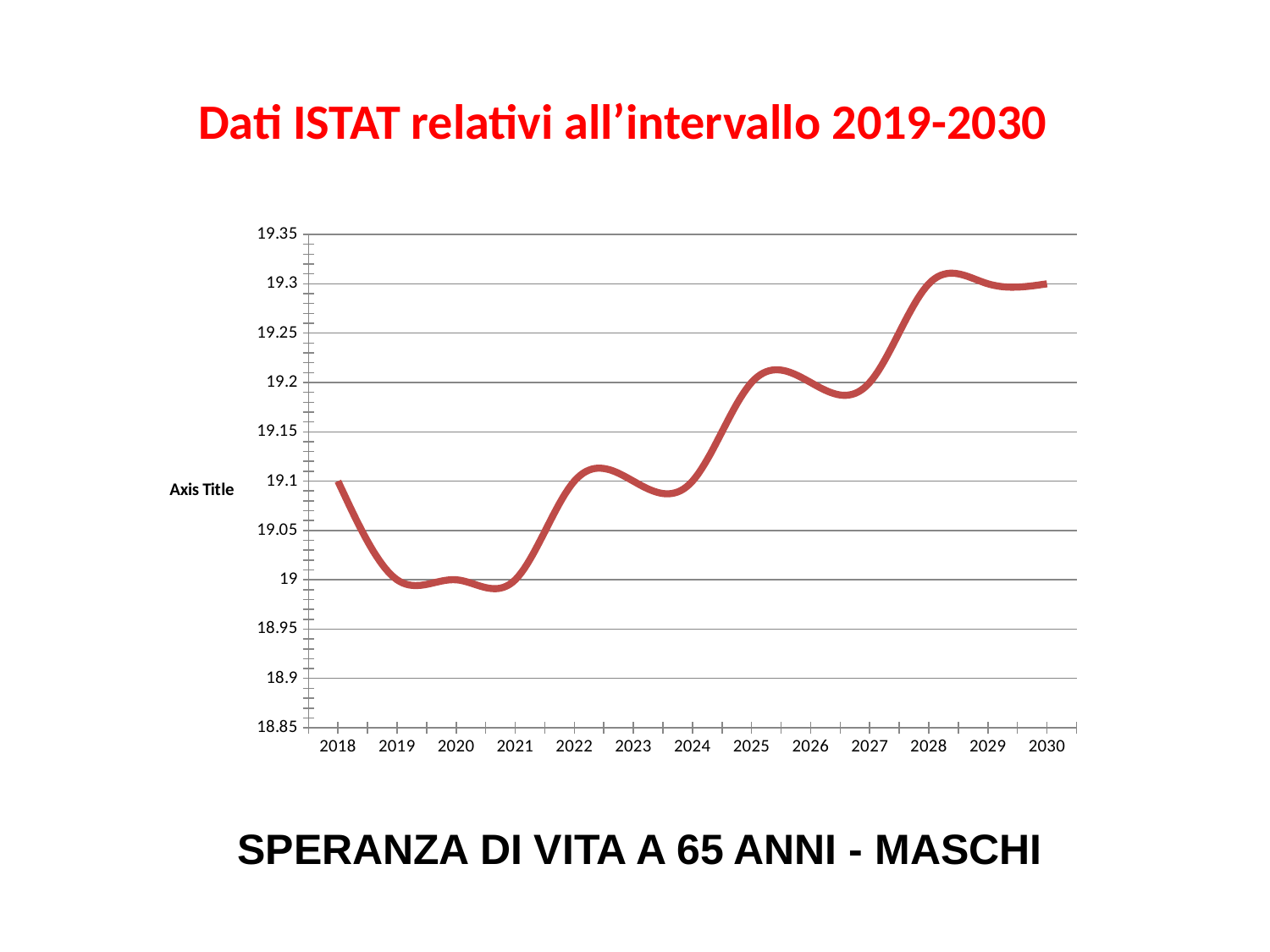
Is the value for 2019 greater or less than 19.05? less Is the value for 2024 greater or less than 19.15? less What is the caption shown below the chart? SPERANZA DI VITA A 65 ANNI - MASCHI What kind of chart is shown on the slide? line chart Is the value for 2022 greater or less than 19.05? greater What is the value for 2018 in the chart? 19.1 How many years are plotted along the x axis of the chart? 13 Which year has the larger value, 2020 or 2026? 2026 Do the values in the chart generally rise or fall from 2018 to 2030? rise Which year has the larger value, 2018 or 2030? 2030